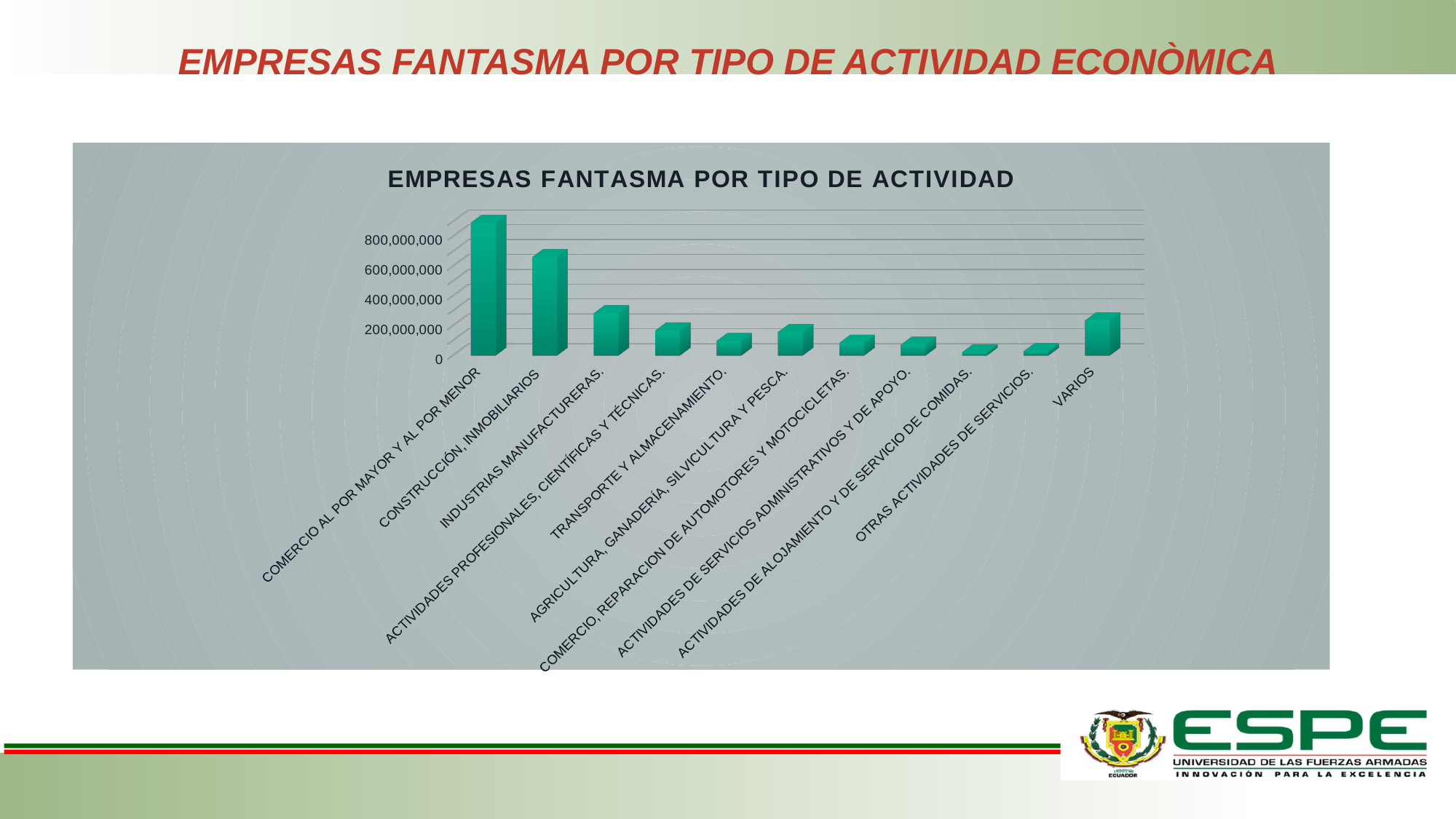
Which category has the highest value in the chart? COMERCIO AL POR MAYOR Y AL POR MENOR Is the value for VARIOS greater or less than 400,000,000? less Which is larger, the value for CONSTRUCCIÓN, INMOBILIARIOS or the value for INDUSTRIAS MANUFACTURERAS? CONSTRUCCIÓN, INMOBILIARIOS What kind of chart is shown on the slide? bar chart Is the value for INDUSTRIAS MANUFACTURERAS greater or less than 400,000,000? less Is the value for COMERCIO AL POR MAYOR Y AL POR MENOR greater or less than 800,000,000? greater Which is larger, the value for VARIOS or the value for TRANSPORTE Y ALMACENAMIENTO? VARIOS What is the title of the chart? EMPRESAS FANTASMA POR TIPO DE ACTIVIDAD How many categories (types of activity) are plotted in the chart? 11 Which is larger, the value for COMERCIO AL POR MAYOR Y AL POR MENOR or the value for CONSTRUCCIÓN, INMOBILIARIOS? COMERCIO AL POR MAYOR Y AL POR MENOR